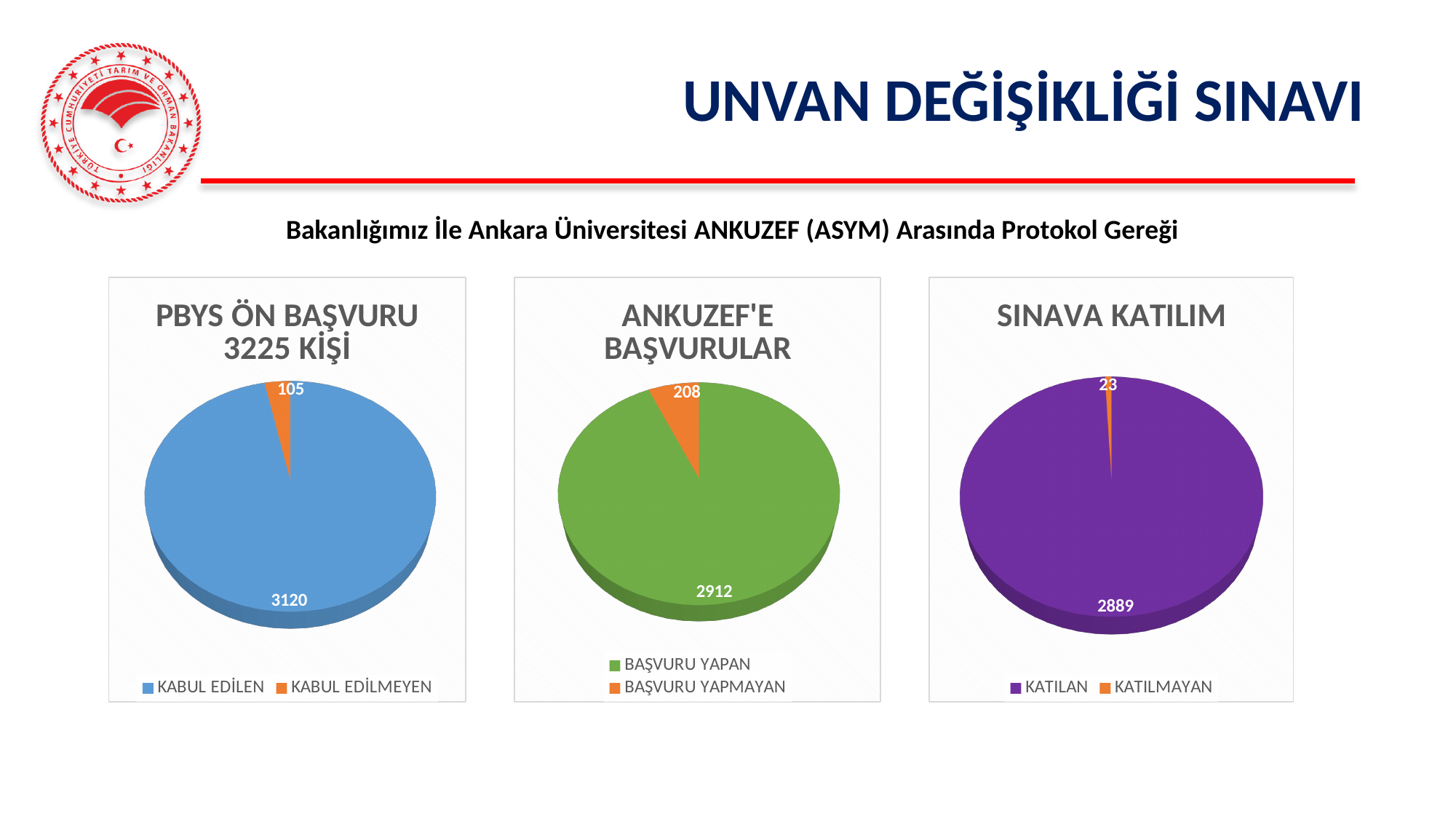
How many slices does the "ANKUZEF'E BAŞVURULAR" pie chart have? 2 In the "ANKUZEF'E BAŞVURULAR" chart, what is the value for BAŞVURU YAPAN? 2912 In the "PBYS ÖN BAŞVURU 3225 KİŞİ" chart, what is the value for KABUL EDİLMEYEN? 105 How many entries does the legend of the "SINAVA KATILIM" chart list? 2 In the "PBYS ÖN BAŞVURU 3225 KİŞİ" chart, what is the difference between KABUL EDİLEN and KABUL EDİLMEYEN? 3015 In the "PBYS ÖN BAŞVURU 3225 KİŞİ" chart, what is the value for KABUL EDİLEN? 3120 In the "ANKUZEF'E BAŞVURULAR" chart, what is the value for BAŞVURU YAPMAYAN? 208 In the "SINAVA KATILIM" chart, what is the total of KATILAN and KATILMAYAN? 2912 In the "SINAVA KATILIM" chart, which category has the largest slice? KATILAN In the "ANKUZEF'E BAŞVURULAR" chart, which category has the smallest slice? BAŞVURU YAPMAYAN In the "SINAVA KATILIM" chart, what is the value for KATILMAYAN? 23 What kind of chart is the "PBYS ÖN BAŞVURU 3225 KİŞİ" chart? Pie chart